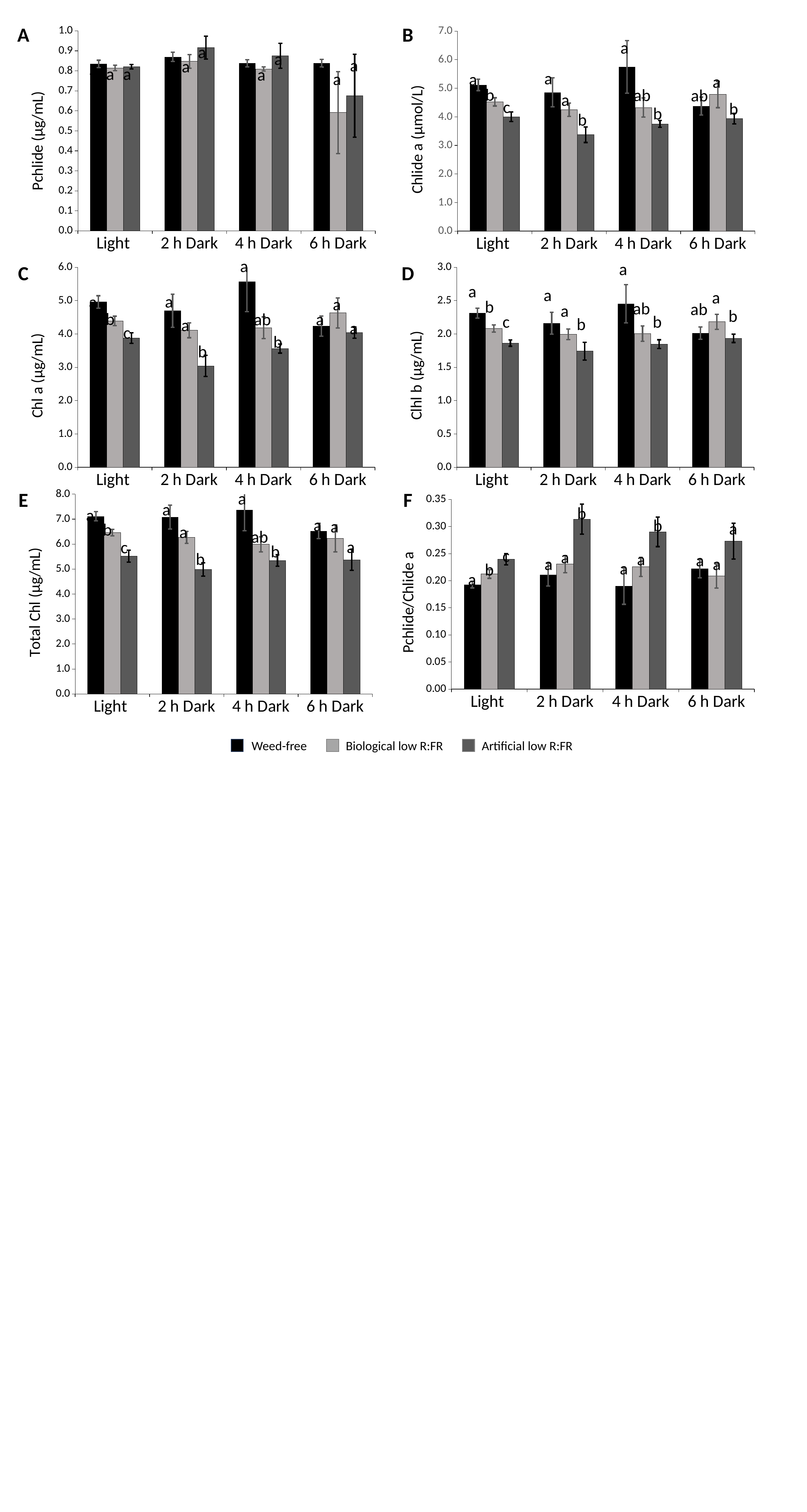
In chart C (Chl a), which is larger at Light: Weed-free or Biological low R:FR? Weed-free How many categories are shown on the x axis of chart C (Chl a)? 4 What kind of chart is chart A (Pchlide)? bar chart How many series does the legend at the bottom of the slide list? 3 In chart C (Chl a), which treatment and time point has the highest bar? Weed-free at 4 h Dark In chart B (Chlide a), is the value for Weed-free at 4 h Dark greater or less than 5.0? greater In chart D (Chl b), is the value for Artificial low R:FR at 2 h Dark greater or less than 2.0? less In chart B (Chlide a), which treatment and time point has the lowest bar? Artificial low R:FR at 2 h Dark In chart E (Total Chl), is the value for Artificial low R:FR at Light greater or less than 6.0? less In chart F (Pchlide/Chlide a), which is larger at 2 h Dark: Weed-free or Artificial low R:FR? Artificial low R:FR What is the y-axis label of chart B? Chlide a (µmol/L)